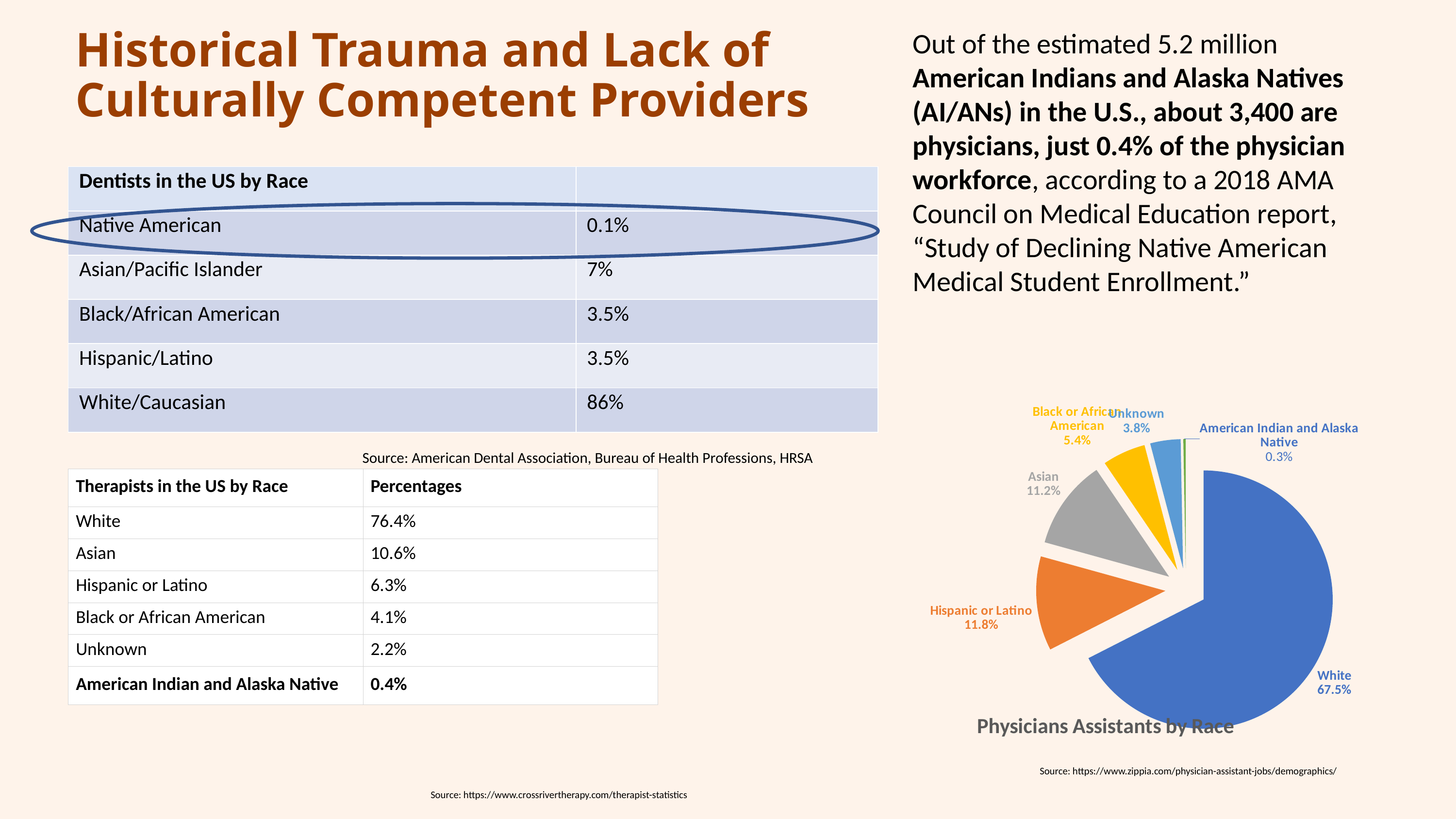
In the "Physicians Assistants by Race" pie chart, what colour is the White slice? Blue In the "Physicians Assistants by Race" pie chart, what share is labelled for Asian? 11.2% In the "Physicians Assistants by Race" pie chart, which is larger, the Black or African American share or the Unknown share? Black or African American What kind of chart is "Physicians Assistants by Race"? Pie chart In the "Physicians Assistants by Race" pie chart, how many slices are there? 6 In the "Physicians Assistants by Race" pie chart, which category has the smallest slice? American Indian and Alaska Native In the "Physicians Assistants by Race" pie chart, which category has the largest slice? White In the "Physicians Assistants by Race" pie chart, what share is labelled for Unknown? 3.8% In the "Physicians Assistants by Race" pie chart, what share is labelled for Hispanic or Latino? 11.8% In the "Physicians Assistants by Race" pie chart, what is the difference between the White share and the Hispanic or Latino share? 55.7% In the "Physicians Assistants by Race" pie chart, what share is labelled for American Indian and Alaska Native? 0.3% In the "Physicians Assistants by Race" pie chart, what share is labelled for White? 67.5%